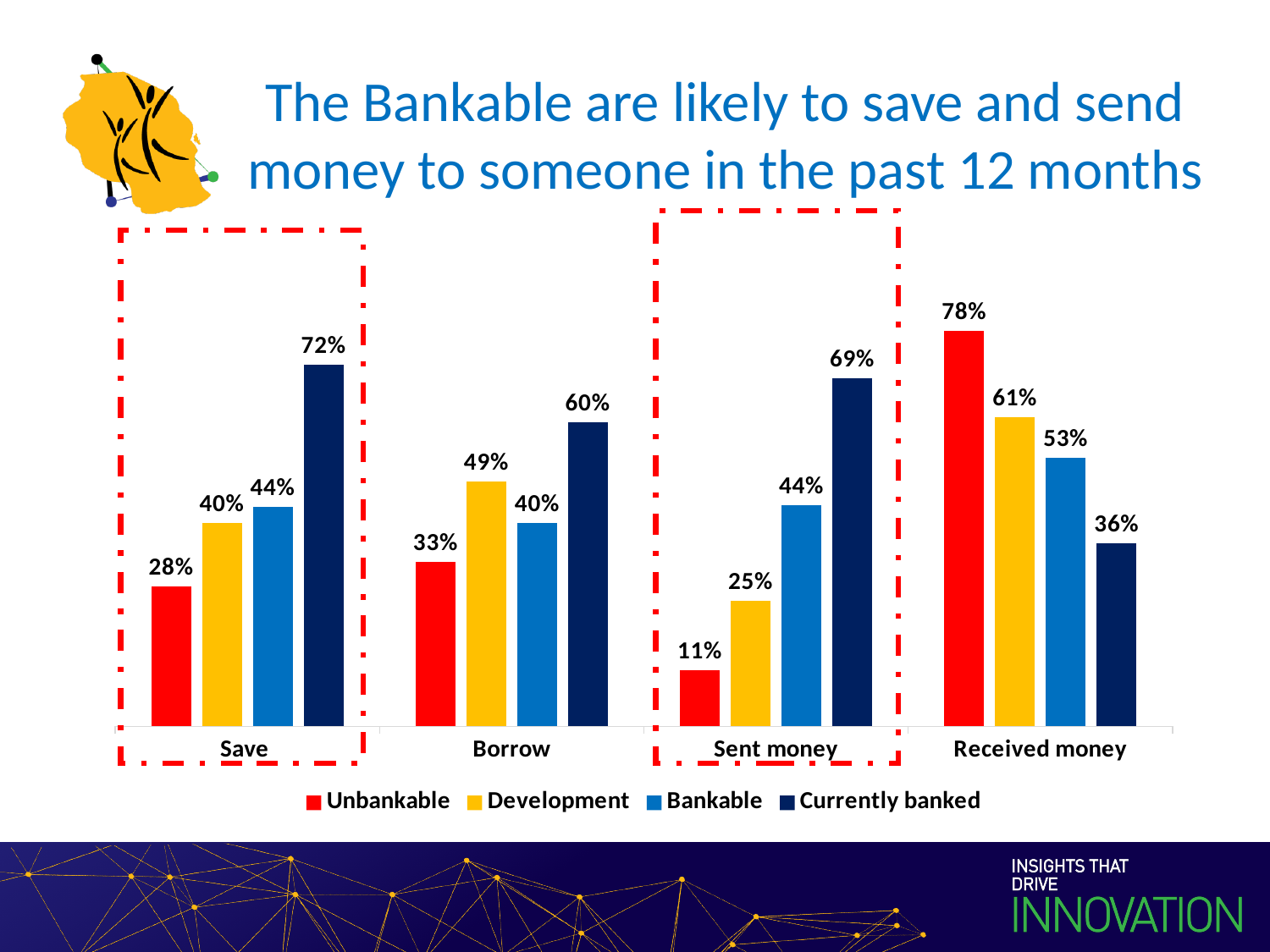
What is the value for Development in the Borrow category? 49% How many series does the legend list? 4 How many categories are shown on the x axis? 4 What is the value for Bankable in the Received money category? 53% What is the value for Currently banked in the Save category? 72% Which series has the lowest value in the Sent money category? Unbankable Which colour represents the Currently banked series? Dark navy blue What is the value for Unbankable in the Sent money category? 11% Which series has the highest value in the Received money category? Unbankable Which is larger in the Borrow category: Development or Bankable? Development What is the difference between the Currently banked and Unbankable values in the Save category? 44% What kind of chart is shown on the slide? Bar chart